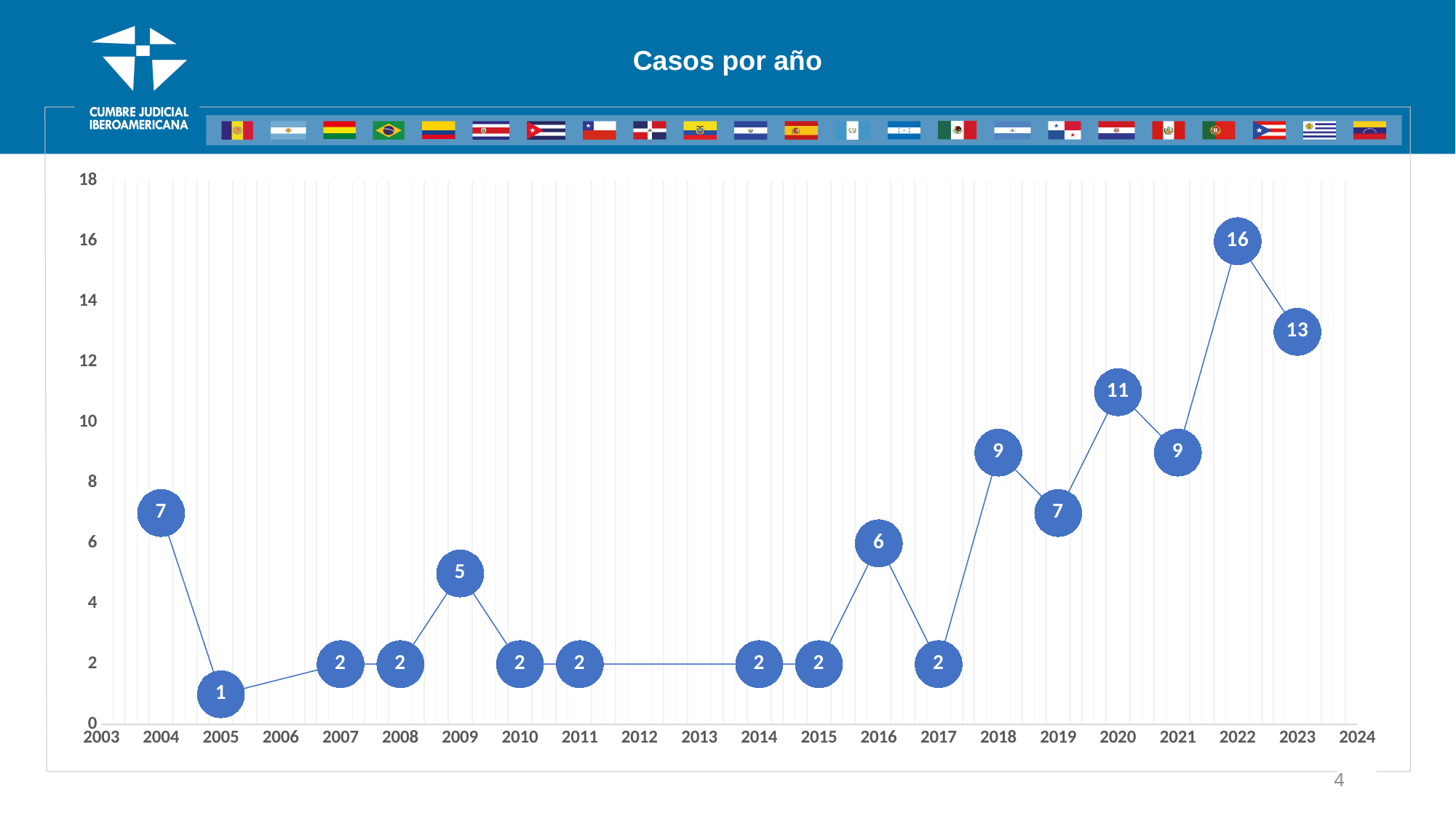
What is the title of the chart? Casos por año What is the difference between the values for 2004 and 2005? 6 What is the difference between the values for 2022 and 2023? 3 What is the value for 2016? 6 What kind of chart is shown on the slide? line chart Which is larger, the value for 2018 or the value for 2019? 2018 What is the value for 2005? 1 What is the value for 2022? 16 How many data points are plotted on the chart? 17 What is the value for 2020? 11 Which year has the highest value? 2022 Which year has the lowest value? 2005